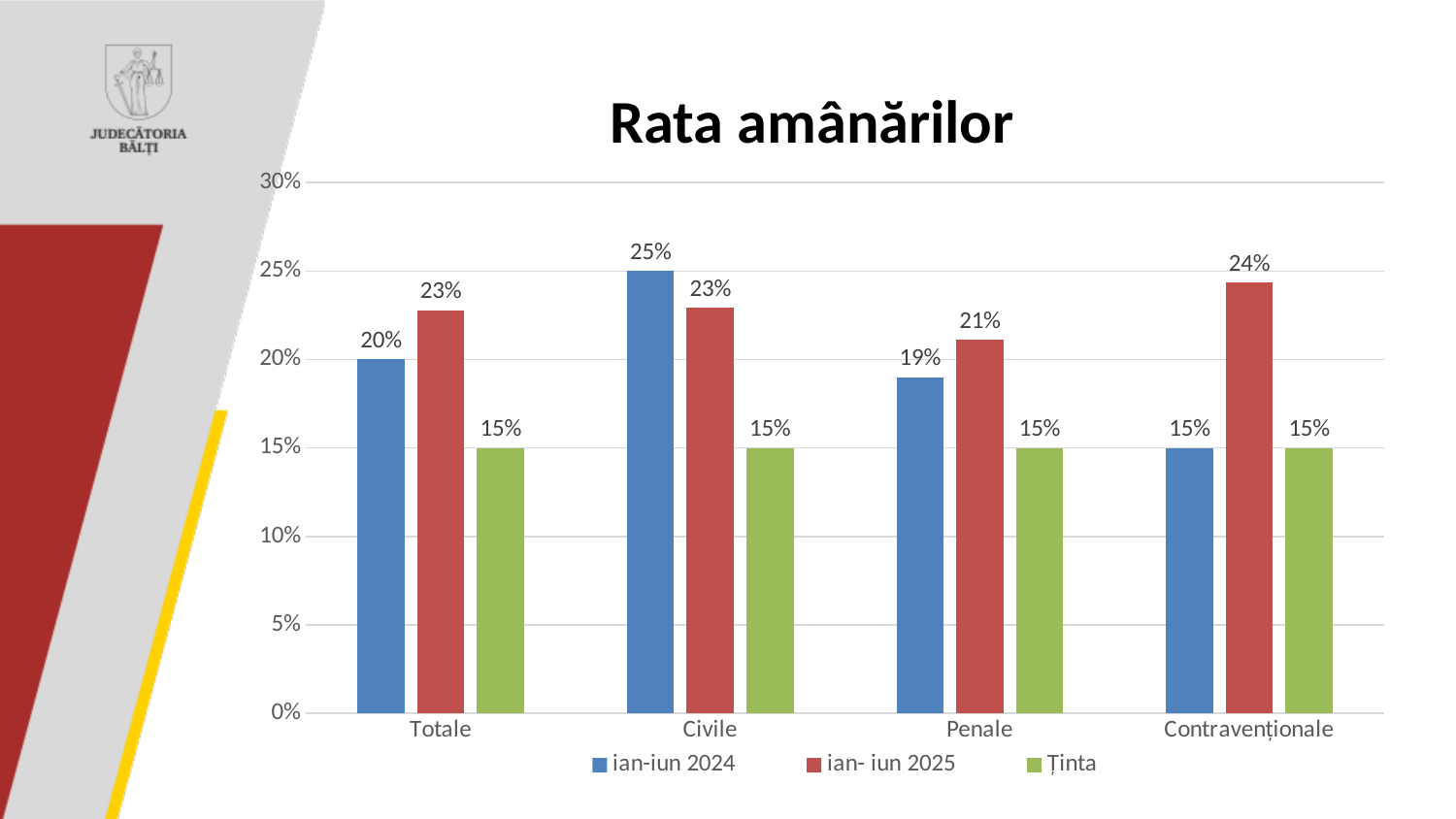
What is the difference between the ian- iun 2025 and ian-iun 2024 values for Contravenționale? 9% What is the value for Civile in the ian-iun 2024 series? 25% Which category has the lowest value in the ian- iun 2025 series? Penale What is the value for Penale in the ian-iun 2024 series? 19% What kind of chart is shown on the slide? Bar chart How many series does the legend list? 3 What is the title of the chart? Rata amânărilor Is the ian-iun 2024 value for Civile greater or less than 20%? greater Which is larger for Totale: the ian-iun 2024 value or the ian- iun 2025 value? ian- iun 2025 What is the value for Contravenționale in the ian- iun 2025 series? 24% Which category has the highest value in the ian-iun 2024 series? Civile How many categories are shown on the x axis? 4